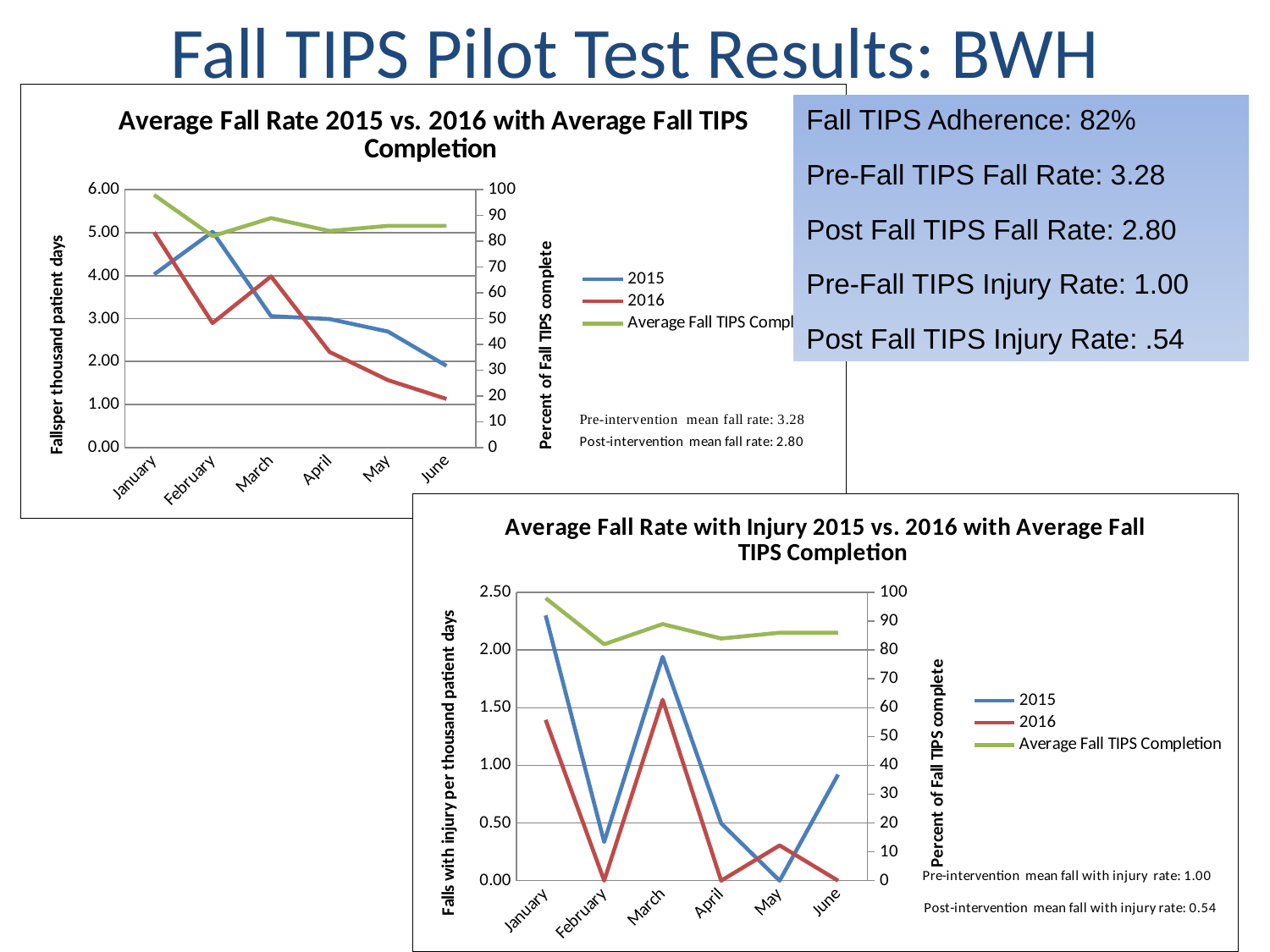
In the bottom chart, is the 2015 value for January greater or less than 2.00? greater In the top chart, which series has the larger value in March, 2015 or 2016? 2016 In the bottom chart, which month has the highest value for the 2015 series? January How many months are shown on the x axis of the top chart? 6 In the top chart, is the 2016 value for June greater or less than 2.00? less In the top chart, which month has the lowest value for the 2016 series? June In the top chart, which month has the highest value for the 2016 series? January How many series does the legend of the top chart list? 3 What kind of chart is the top chart, 'Average Fall Rate 2015 vs. 2016 with Average Fall TIPS Completion'? Line chart In the top chart, does the 2016 series generally rise or fall from January to June? Fall In the bottom chart, 'Average Fall Rate with Injury 2015 vs. 2016 with Average Fall TIPS Completion', what is the 2016 value for February? 0.00 What is the label of the right-hand vertical axis in the bottom chart? Percent of Fall TIPS complete